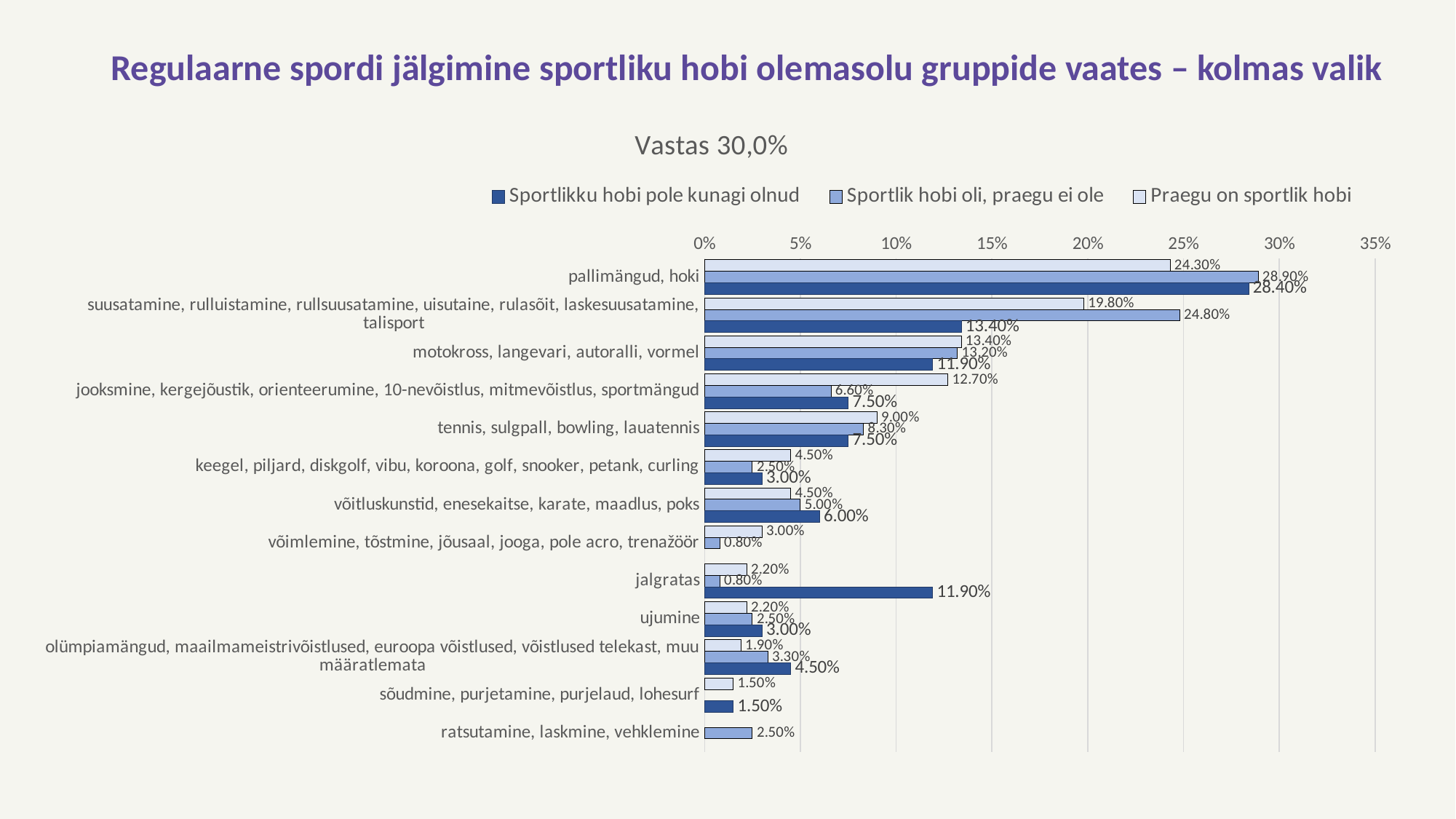
How many series does the legend list? 3 What is the title of the chart? Vastas 30,0% Is the "Sportlik hobi oli, praegu ei ole" value for "suusatamine, rulluistamine, rullsuusatamine, uisutaine, rulasõit, laskesuusatamine, talisport" greater or less than 20%? greater Which category has the highest value for "Praegu on sportlik hobi"? pallimängud, hoki What is the value for "Sportlik hobi oli, praegu ei ole" in the category "pallimängud, hoki"? 28.90% How many categories are shown on the vertical axis? 13 What is the value for "Praegu on sportlik hobi" in the category "jooksmine, kergejõustik, orienteerumine, 10-nevõistlus, mitmevõistlus, sportmängud"? 12.70% What is the value for "Sportlik hobi oli, praegu ei ole" in the category "ratsutamine, laskmine, vehklemine"? 2.50% What is the difference between the "Praegu on sportlik hobi" and "Sportlikku hobi pole kunagi olnud" values for "suusatamine, rulluistamine, rullsuusatamine, uisutaine, rulasõit, laskesuusatamine, talisport"? 6.40% For "jalgratas", which is larger: the value for "Sportlikku hobi pole kunagi olnud" or the value for "Praegu on sportlik hobi"? Sportlikku hobi pole kunagi olnud What kind of chart is shown on the slide? bar chart What is the value for "Sportlikku hobi pole kunagi olnud" in the category "jalgratas"? 11.90%